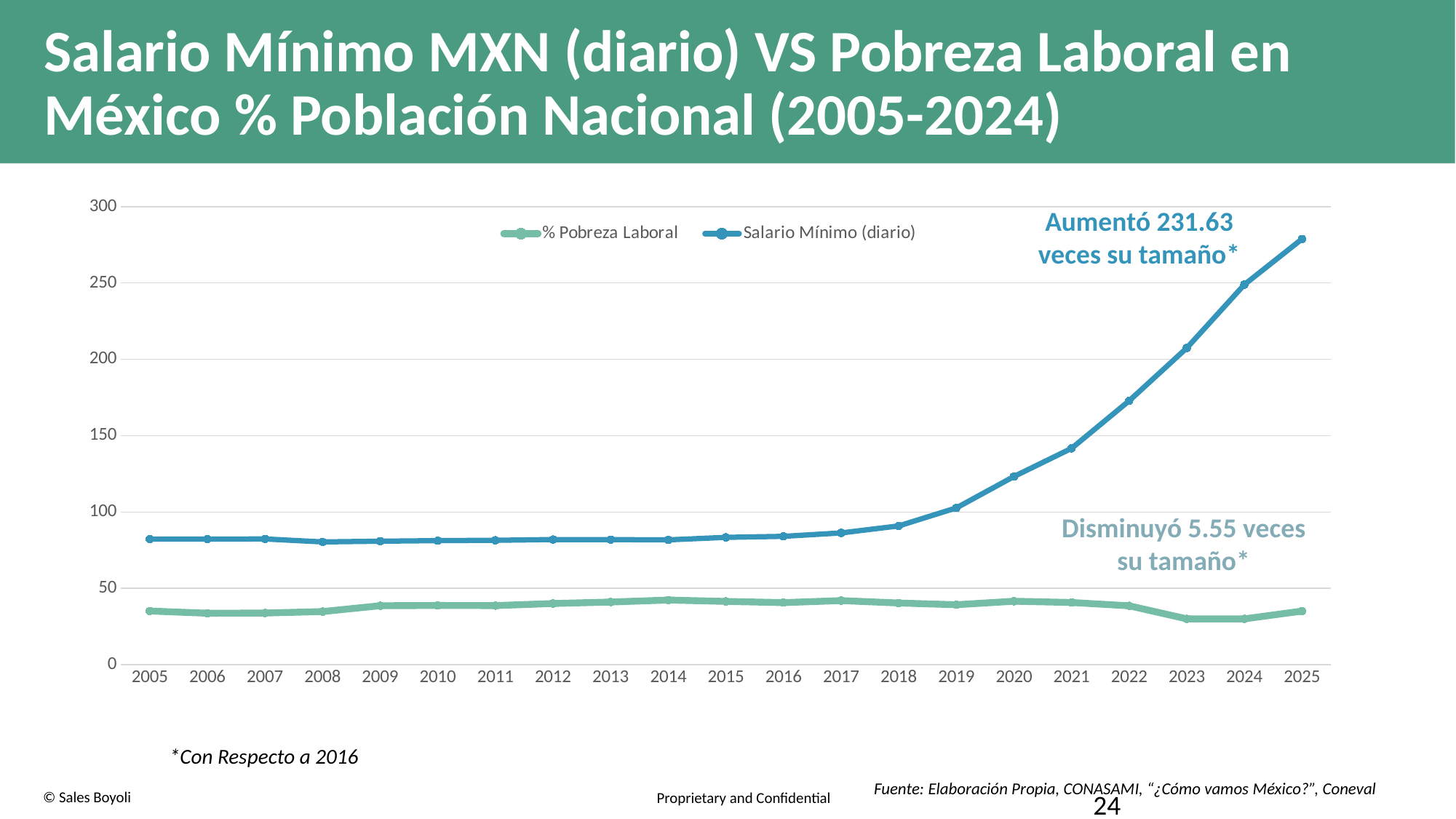
How many series does the legend list? 2 Is the Salario Mínimo (diario) value for 2025 greater or less than 250? greater What kind of chart is shown on the slide? Line chart Is the Salario Mínimo (diario) value for 2022 greater or less than 150? greater According to the annotation on the chart, by how many times did the Salario Mínimo increase in size? 231.63 veces Which series has the larger value in 2020, % Pobreza Laboral or Salario Mínimo (diario)? Salario Mínimo (diario) How many years are plotted along the x axis? 21 Is the % Pobreza Laboral value for 2025 greater or less than 50? less Which is larger for Salario Mínimo (diario): the value in 2005 or the value in 2025? 2025 Does the Salario Mínimo (diario) series rise or fall from 2018 to 2025? Rise In which year is the Salario Mínimo (diario) value highest? 2025